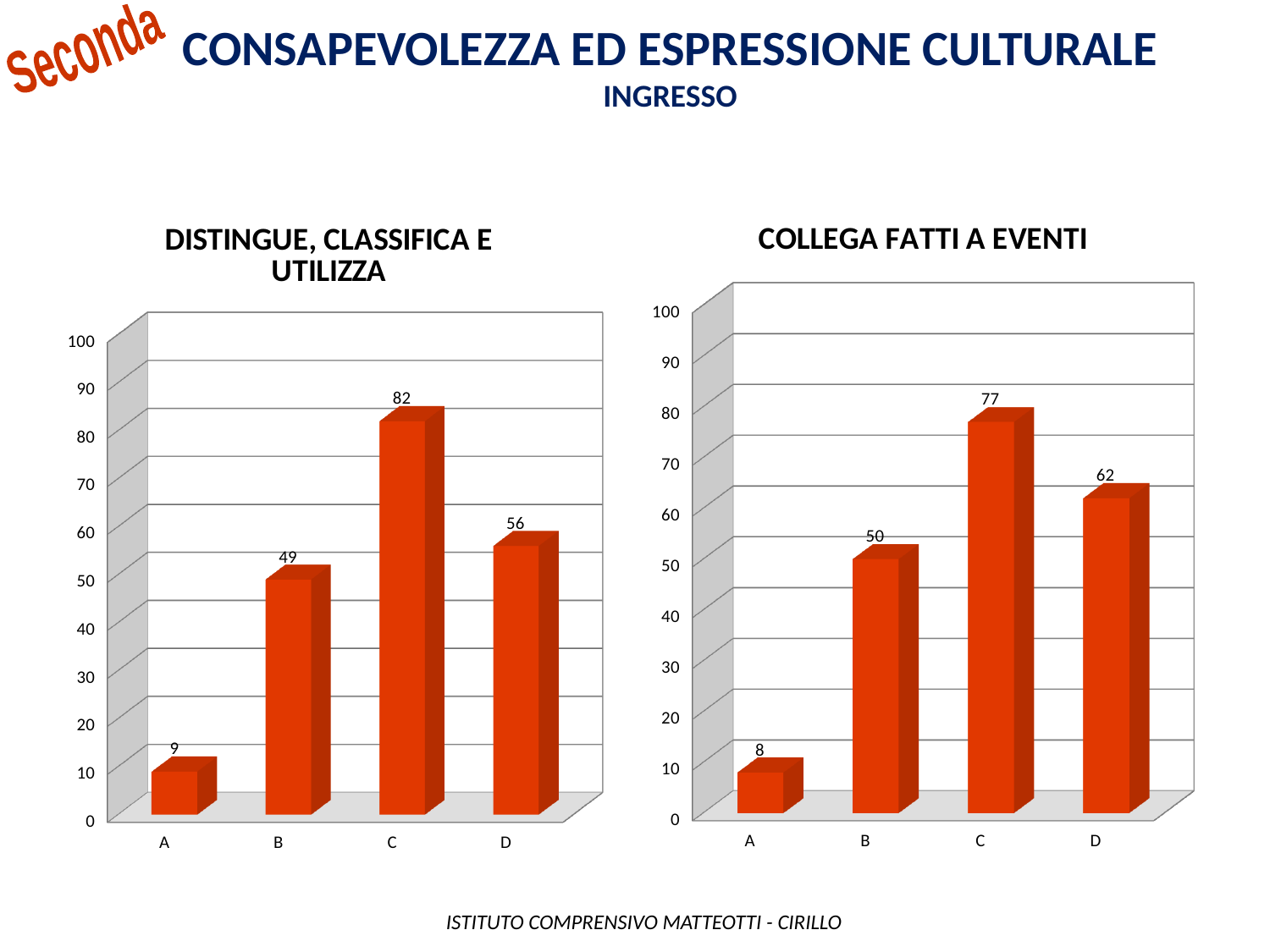
In the chart titled 'COLLEGA FATTI A EVENTI', what is the difference between the values for D and A? 54 In the chart titled 'DISTINGUE, CLASSIFICA E UTILIZZA', which category has the lowest value? A In the chart titled 'DISTINGUE, CLASSIFICA E UTILIZZA', what is the value for category A? 9 In the chart titled 'COLLEGA FATTI A EVENTI', what is the value for category B? 50 In the chart titled 'COLLEGA FATTI A EVENTI', which category has the highest value? C In the chart titled 'COLLEGA FATTI A EVENTI', which is larger, the value for B or the value for D? D What is the title of the chart on the right side of the slide? COLLEGA FATTI A EVENTI How many categories are shown in the chart titled 'COLLEGA FATTI A EVENTI'? 4 In the chart titled 'DISTINGUE, CLASSIFICA E UTILIZZA', what is the difference between the values for C and D? 26 What kind of chart is the chart titled 'DISTINGUE, CLASSIFICA E UTILIZZA'? bar chart In the chart titled 'DISTINGUE, CLASSIFICA E UTILIZZA', what is the value for category C? 82 In the chart titled 'DISTINGUE, CLASSIFICA E UTILIZZA', is the value for B greater or less than 50? less